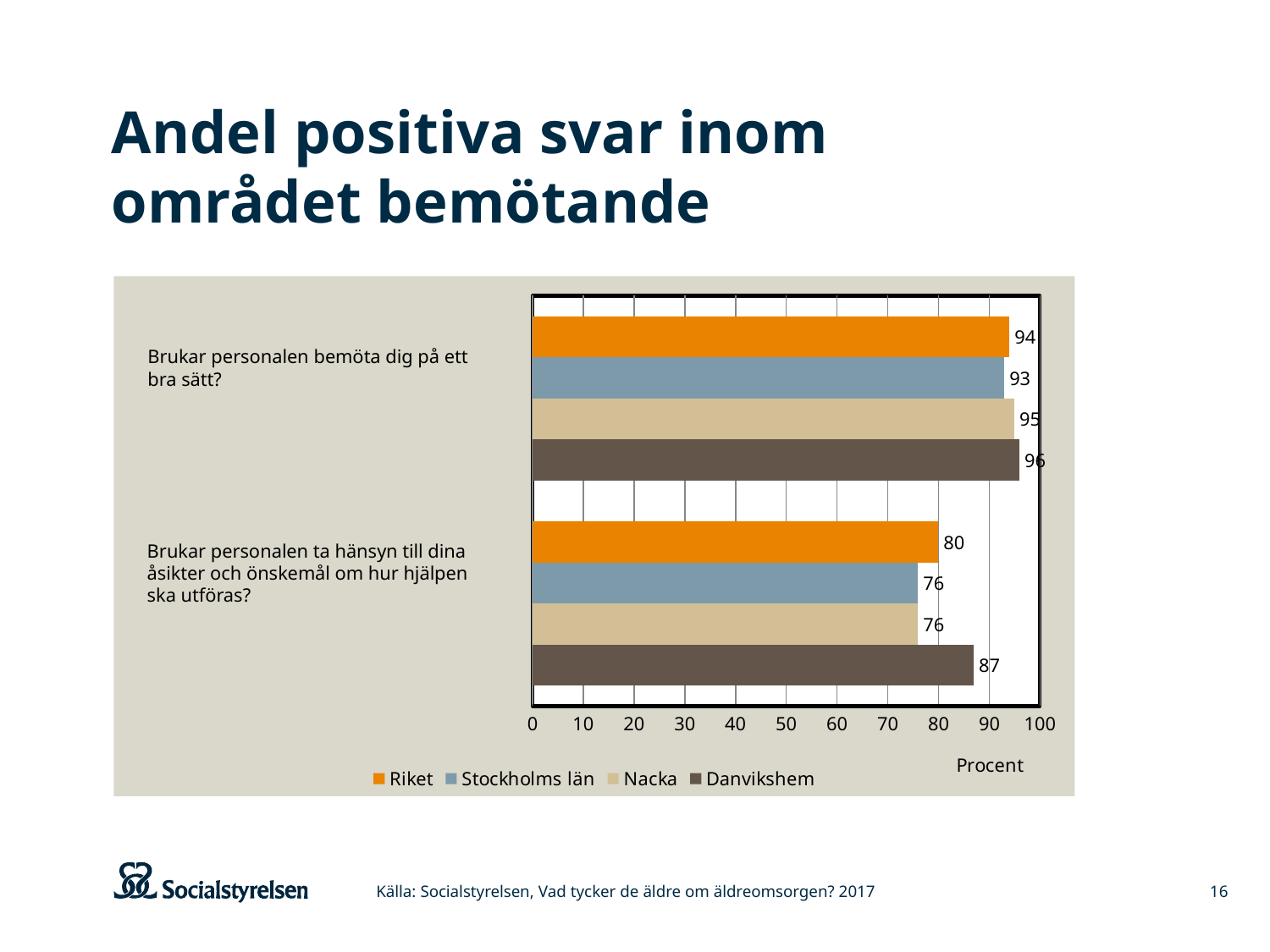
Which series has the lowest value on the question "Brukar personalen bemöta dig på ett bra sätt?"? Stockholms län How many series does the legend list? 4 Which series has the highest value on the question "Brukar personalen ta hänsyn till dina åsikter och önskemål om hur hjälpen ska utföras?"? Danvikshem What is the value for Danvikshem on the question "Brukar personalen ta hänsyn till dina åsikter och önskemål om hur hjälpen ska utföras?"? 87 What is the value for Stockholms län on the question "Brukar personalen bemöta dig på ett bra sätt?"? 93 How many questions (categories) are shown on the chart? 2 Which is larger on the question "Brukar personalen ta hänsyn till dina åsikter och önskemål om hur hjälpen ska utföras?": Riket or Nacka? Riket What is the difference between Danvikshem and Riket on the question "Brukar personalen ta hänsyn till dina åsikter och önskemål om hur hjälpen ska utföras?"? 7 What kind of chart is shown on the slide? bar chart What is the value for Nacka on the question "Brukar personalen ta hänsyn till dina åsikter och önskemål om hur hjälpen ska utföras?"? 76 What is the value for Riket on the question "Brukar personalen bemöta dig på ett bra sätt?"? 94 What is the label on the horizontal axis of the chart? Procent